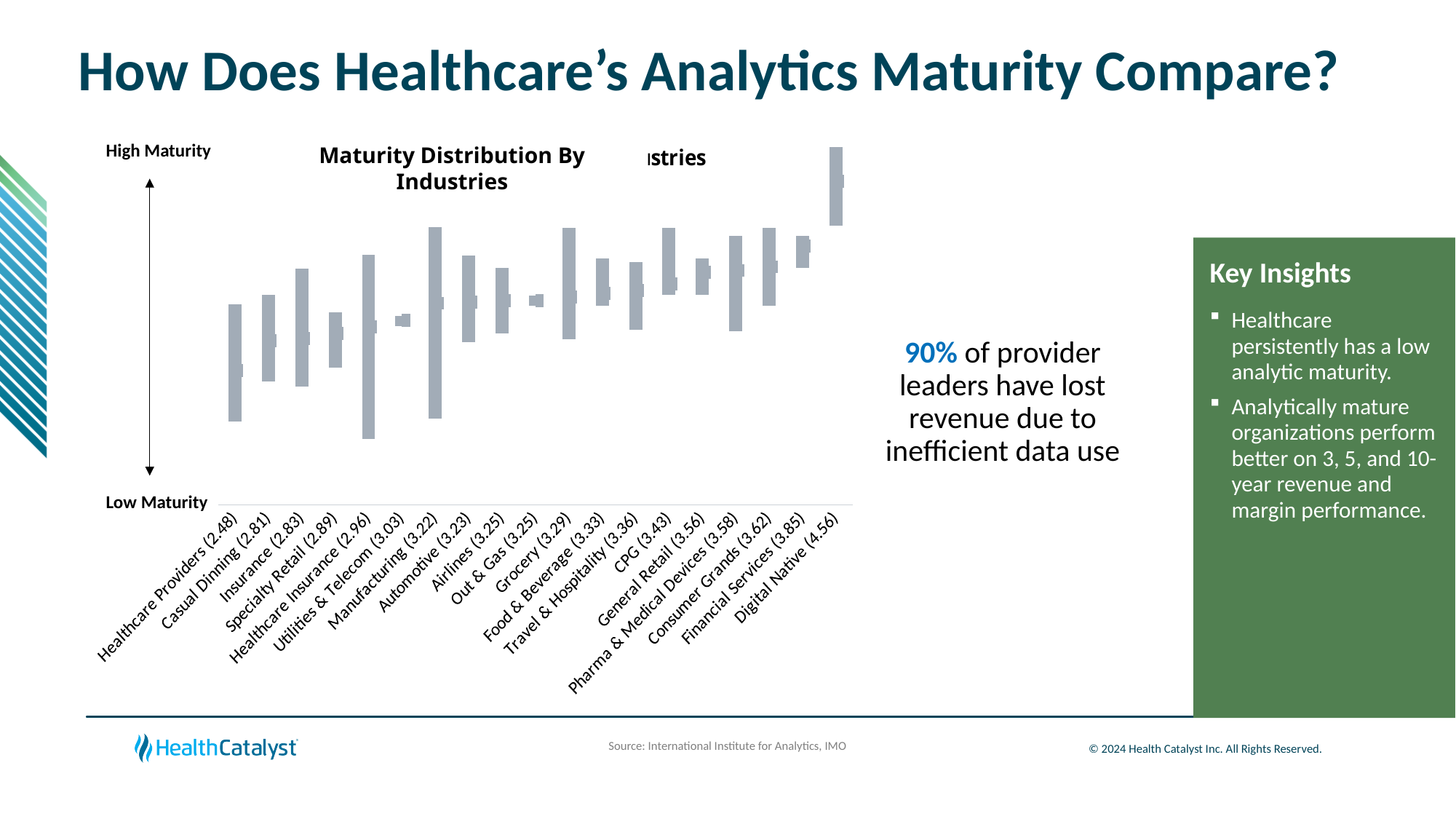
What maturity value is printed in the label for Manufacturing? 3.22 Do the labelled maturity values rise or fall moving left to right along the x axis? rise Which industry has the highest maturity value in its label? Digital Native How many industries are shown along the x axis of the chart? 19 What type of chart is used to show the maturity distribution by industries? bar chart Which industry has the lowest maturity value in its label? Healthcare Providers What is the difference between the labelled maturity values of Digital Native and Healthcare Providers? 2.08 What maturity value is printed in the label for Digital Native? 4.56 What is the title of the chart on the slide? Maturity Distribution By Industries What maturity value is printed in the label for Healthcare Providers? 2.48 Which has a higher labelled maturity value, General Retail or Grocery? General Retail What maturity value is printed in the label for Financial Services? 3.85